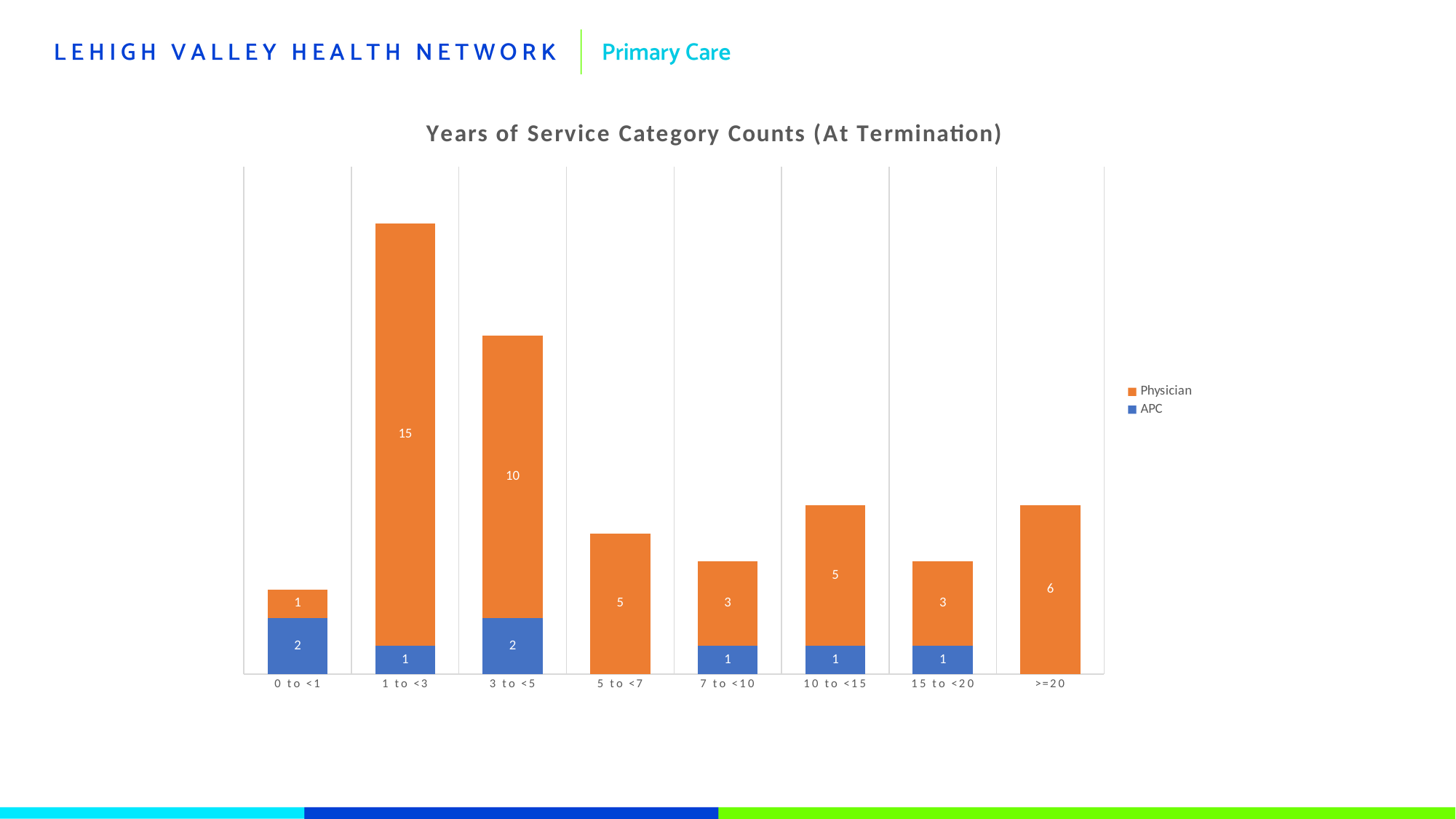
Which years of service category has the lowest Physician count? 0 to <1 What is the Physician count for the 1 to <3 years of service category? 15 How many years of service categories are shown on the x axis? 8 What is the total count (Physician plus APC) for the 1 to <3 category? 16 What is the APC count for the 0 to <1 years of service category? 2 Which is larger, the Physician count for 10 to <15 or for 15 to <20? 10 to <15 What is the total count (Physician plus APC) for the 3 to <5 category? 12 What is the difference between the Physician counts for 1 to <3 and 3 to <5? 5 What type of chart is shown on the slide? Stacked bar chart Which years of service category has the highest Physician count? 1 to <3 What is the Physician count for the >=20 years of service category? 6 How many series does the legend list? 2